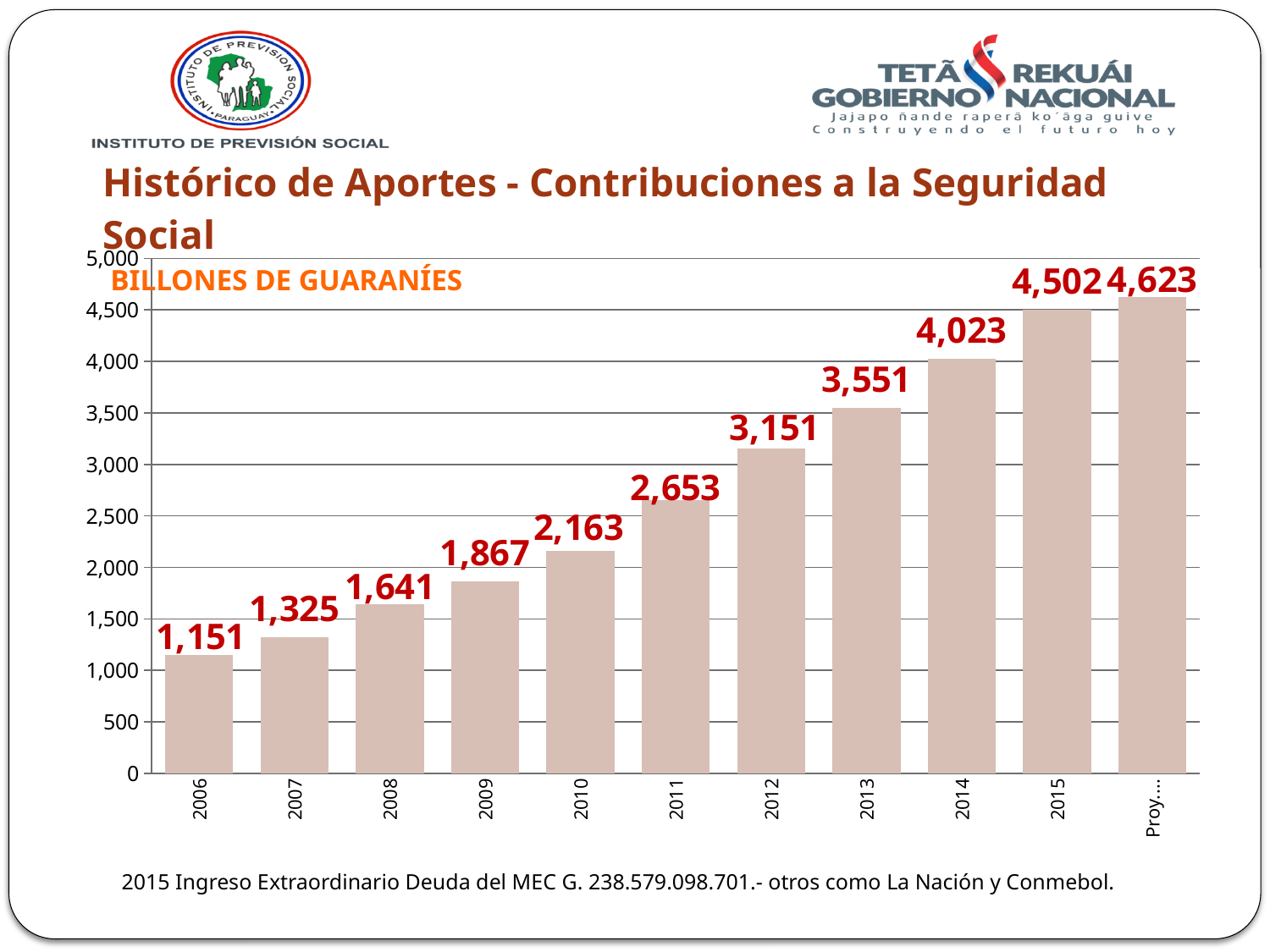
What is the value for 2006? 1,151 What kind of chart is shown on the slide? bar chart Which is larger, the value for 2011 or the value for 2012? 2012 What is the difference between the values for 2015 and 2014? 479 What is the value for 2010? 2,163 Which category has the highest value? Proy.... (the last bar) How many bars are shown in the chart? 11 What unit label is shown in the top-left corner of the chart? BILLONES DE GUARANÍES Do the values rise or fall from 2006 to 2015? rise Is the value for 2009 greater or less than 2,000? less What is the value for 2013? 3,551 Which year has the lowest value? 2006